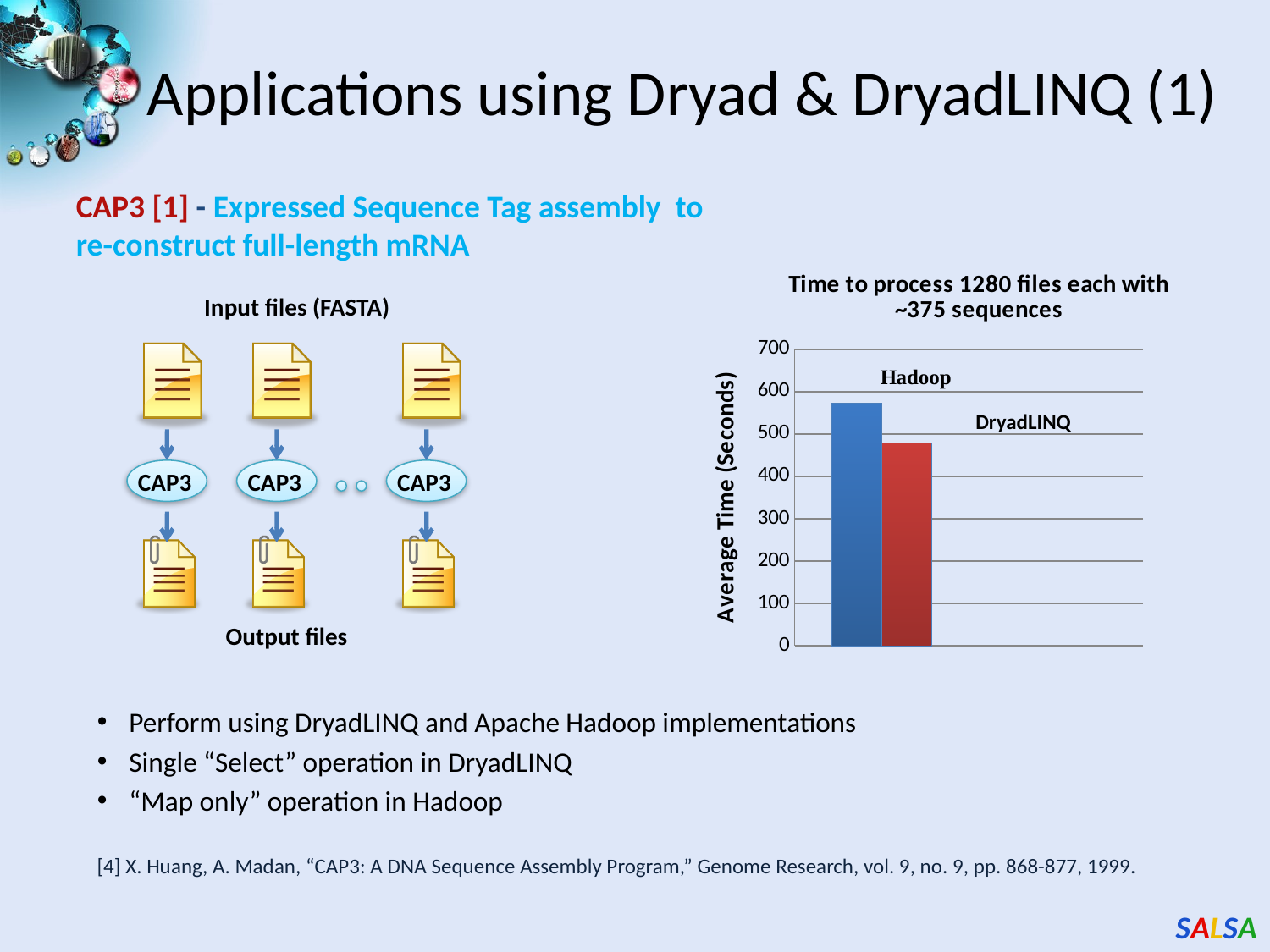
What kind of chart is shown on the slide? bar chart Which implementation has the highest average time in the chart? Hadoop Which implementation has the lowest average time in the chart? DryadLINQ Is the value for DryadLINQ greater or less than 400? greater Which has a larger average time, Hadoop or DryadLINQ? Hadoop Is the value for DryadLINQ greater or less than 500? less How many bars are plotted in the chart? 2 Is the value for Hadoop greater or less than 600? less What is the label of the vertical axis of the chart? Average Time (Seconds) What is the title of the chart? Time to process 1280 files each with ~375 sequences